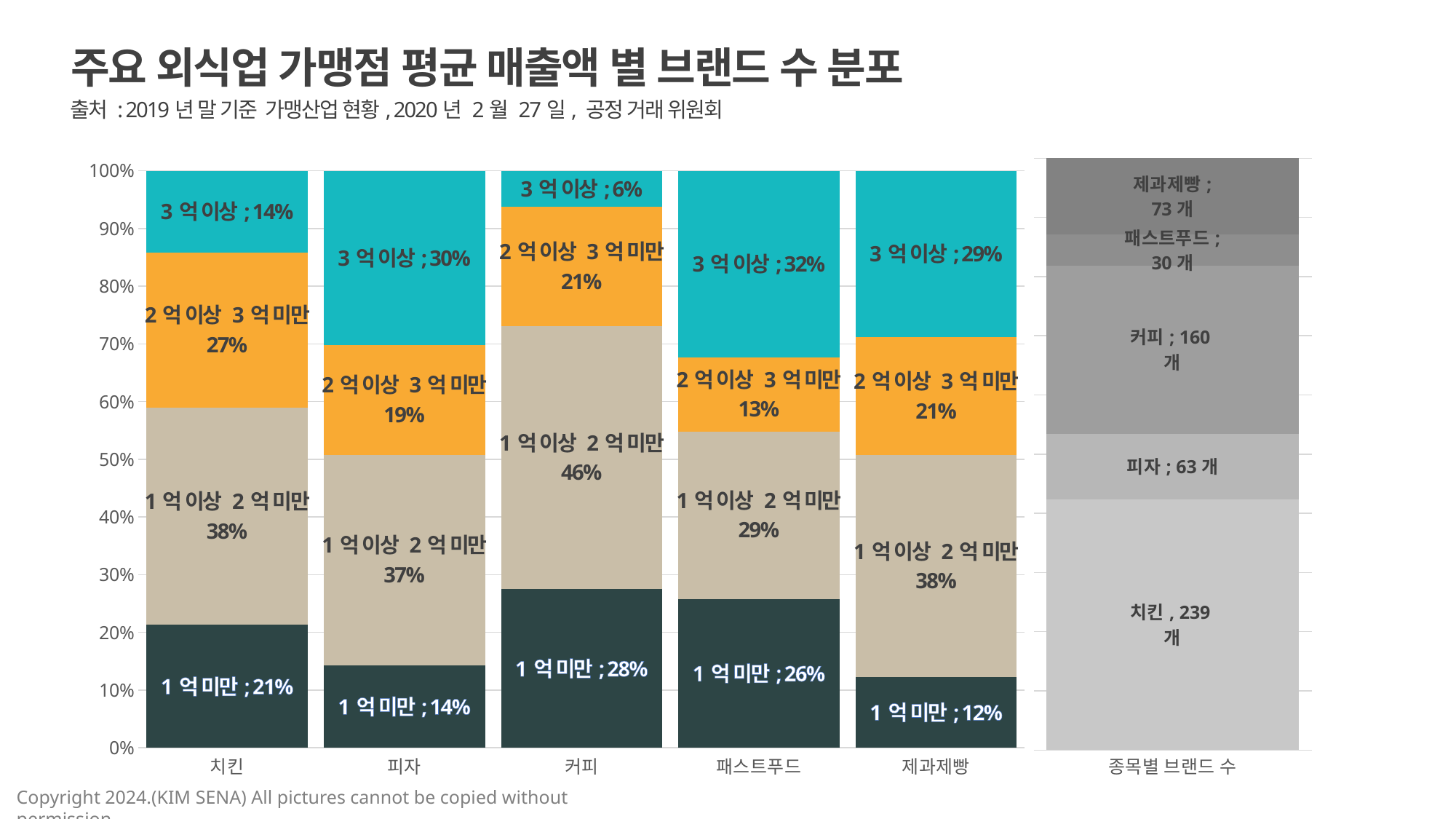
How many food categories are shown as stacked percentage bars (excluding the 종목별 브랜드 수 bar)? 5 Which category has the most brands in the 종목별 브랜드 수 bar? 치킨 What kind of chart is shown on the slide? Stacked bar chart What percentage of 커피 brands fall in the 3 억 이상 segment? 6% How many brands does the 종목별 브랜드 수 bar show for 패스트푸드? 30 개 What is the difference between the 1 억 이상 2 억 미만 share for 커피 and for 치킨? 8 percentage points How many brands does the 종목별 브랜드 수 bar show for 치킨? 239 개 What is the title of the chart? 주요 외식업 가맹점 평균 매출액 별 브랜드 수 분포 What is the total of the four segments in the 치킨 bar? 100% Which has a larger 3 억 이상 share, 피자 or 제과제빵? 피자 Which category has the largest 3 억 이상 share? 패스트푸드 Which category has the smallest 1 억 미만 share? 제과제빵